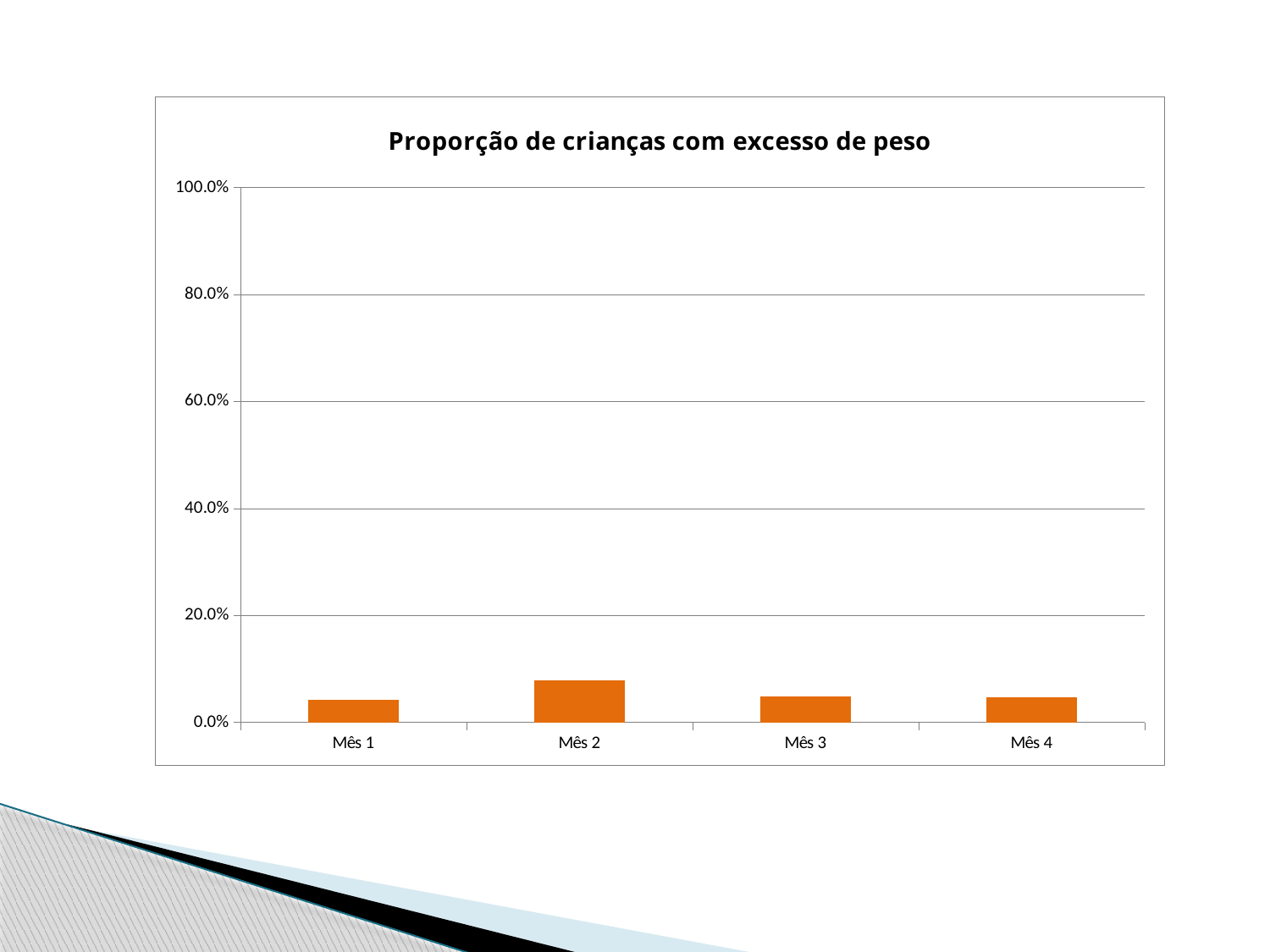
How many categories are plotted on the x axis? 4 Which category has the highest value? Mês 2 Is the value for Mês 2 greater or less than 20%? less Is the value for Mês 3 greater or less than 40%? less What is the highest value shown on the y axis? 100.0% Is the value for Mês 4 greater or less than 20%? less What is the title of the chart? Proporção de crianças com excesso de peso Which is larger, the value for Mês 2 or the value for Mês 1? Mês 2 Which is larger, the value for Mês 2 or the value for Mês 3? Mês 2 What kind of chart is shown on the slide? Bar chart